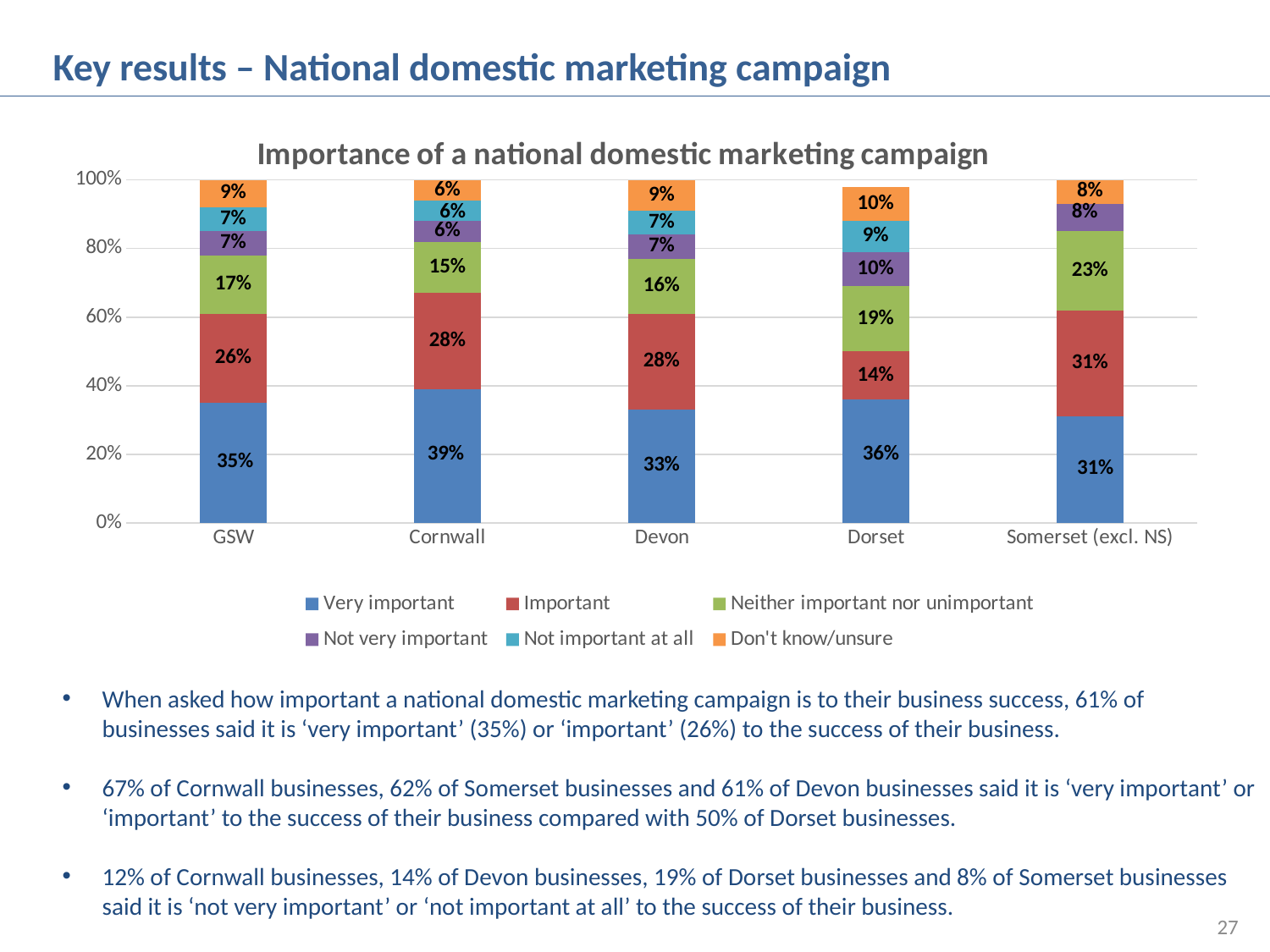
What is the 'Neither important nor unimportant' value for Somerset (excl. NS)? 23% What kind of chart is shown on the slide? Stacked bar chart What is the 'Don't know/unsure' value for Dorset? 10% Which area has the lowest 'Very important' value? Somerset (excl. NS) What is the 'Important' value for Dorset? 14% Which area has the highest 'Neither important nor unimportant' value? Somerset (excl. NS) How many series does the legend list? 6 What is the title of the chart? Importance of a national domestic marketing campaign What is the difference between the 'Important' values for Somerset (excl. NS) and Dorset? 17 percentage points What percentage of Cornwall businesses said the campaign is 'Very important'? 39% Which has the larger 'Very important' value, GSW or Devon? GSW Which area has the highest 'Very important' value? Cornwall